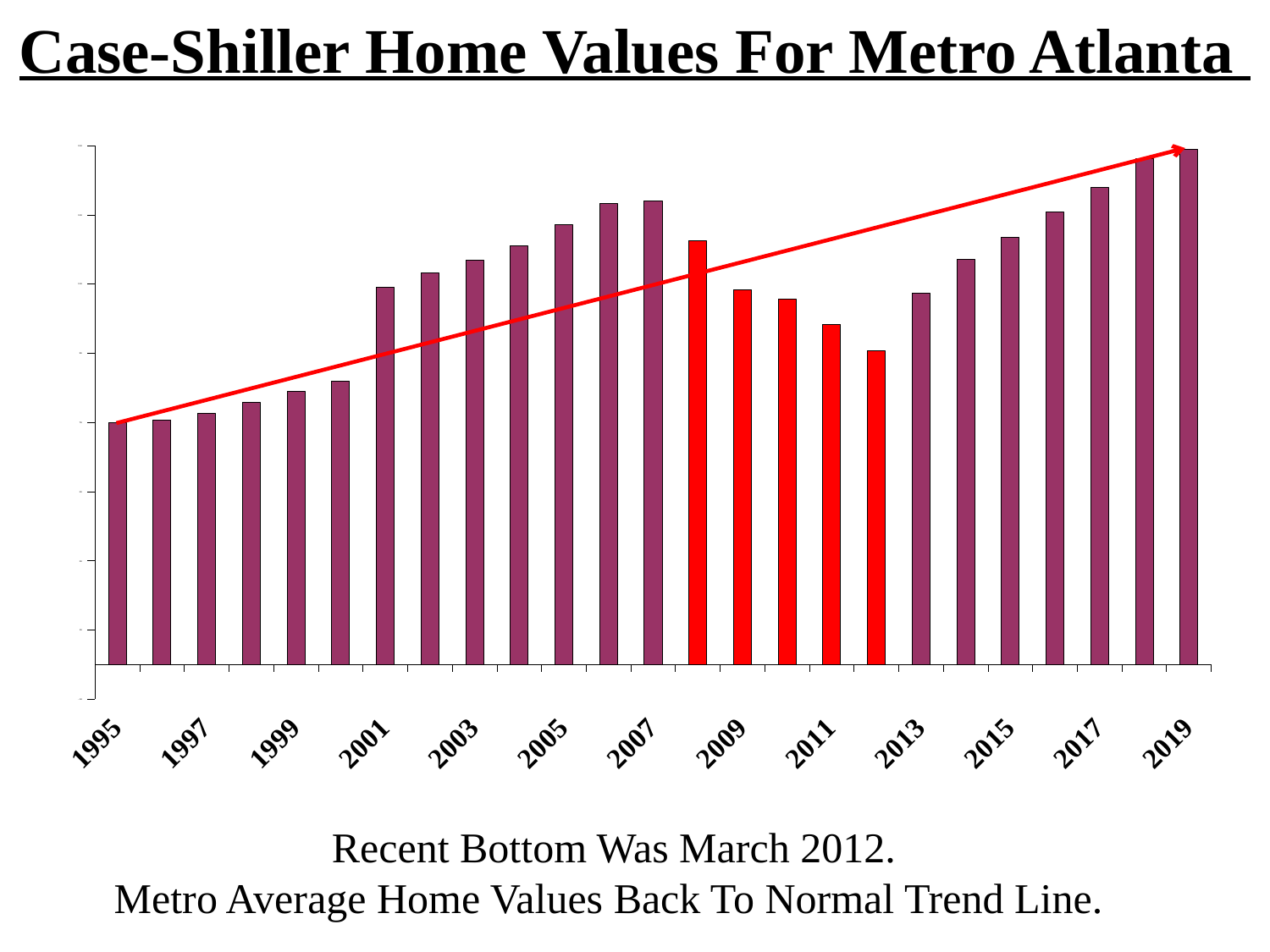
Which year has the lowest bar in the chart? 1995 Do the values rise or fall from 2012 to 2019? rise Which year has the larger value, 2001 or 2000? 2001 How many bars are coloured bright red in the chart? 5 What is the title of the slide's chart? Case-Shiller Home Values For Metro Atlanta What kind of chart is shown on the slide? bar chart How many bars (years) are plotted in the chart? 25 Which year has the highest bar in the chart? 2019 Do the values rise or fall from 2007 to 2012? fall Which year has the larger value, 2007 or 2012? 2007 Which year has the larger value, 2019 or 2007? 2019 Among the bright red bars, which year has the lowest value? 2012